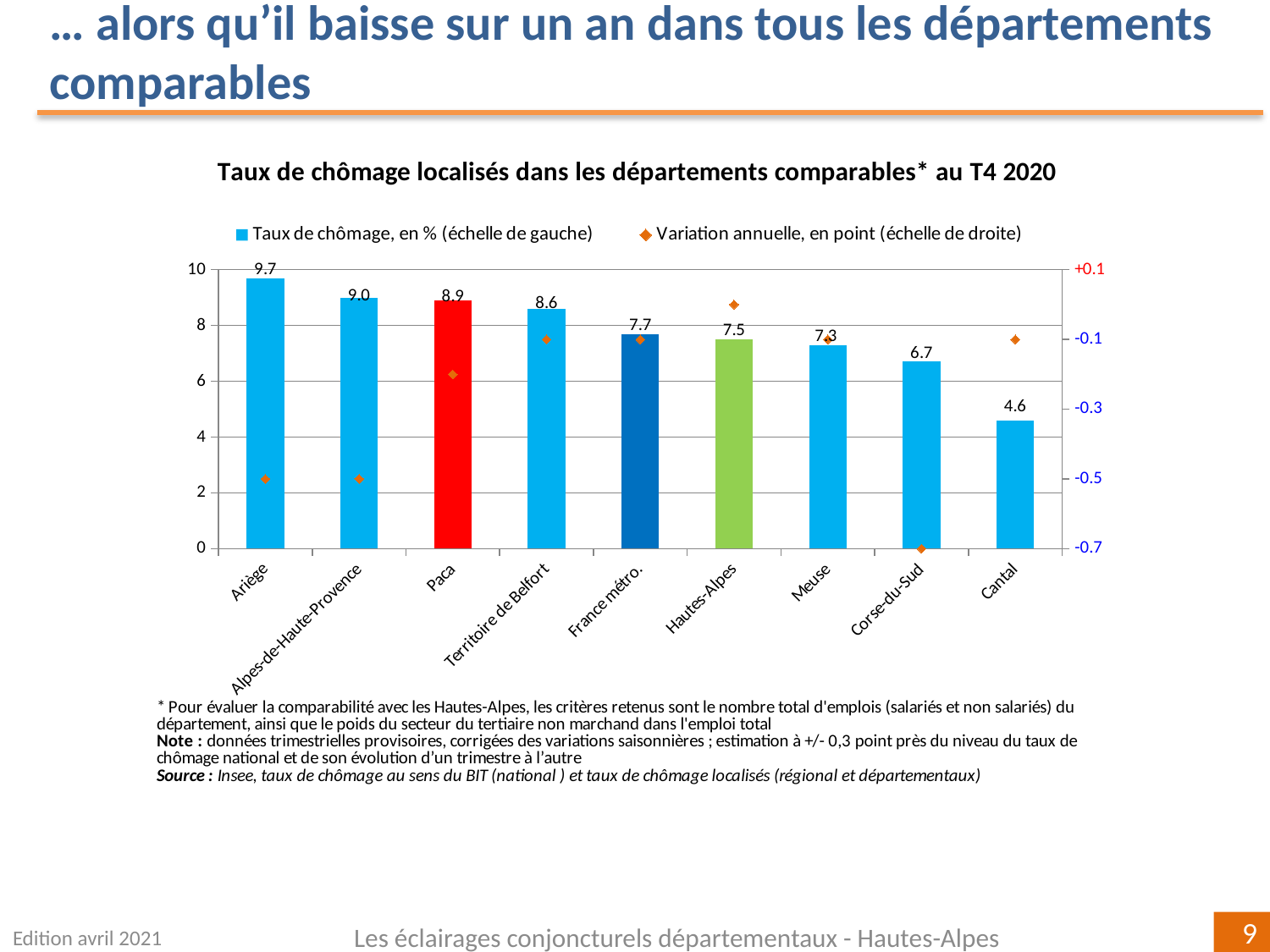
What is the unemployment rate (taux de chômage) shown for Ariège? 9.7 Which category has the lowest unemployment rate in the chart? Cantal What is the unemployment rate shown for Cantal? 4.6 Which department has the highest unemployment rate in the chart? Ariège What is the unemployment rate shown for Hautes-Alpes? 7.5 How many series does the legend list? 2 How many categories are shown on the x axis of the chart? 9 What is the difference between the unemployment rates of Ariège and Cantal? 5.1 Is the annual variation (variation annuelle) for Corse-du-Sud greater or less than -0.5? less Which has a higher unemployment rate, Meuse or Corse-du-Sud? Meuse Is the annual variation for Hautes-Alpes greater or less than -0.1? greater What colour is the bar for Paca? Red